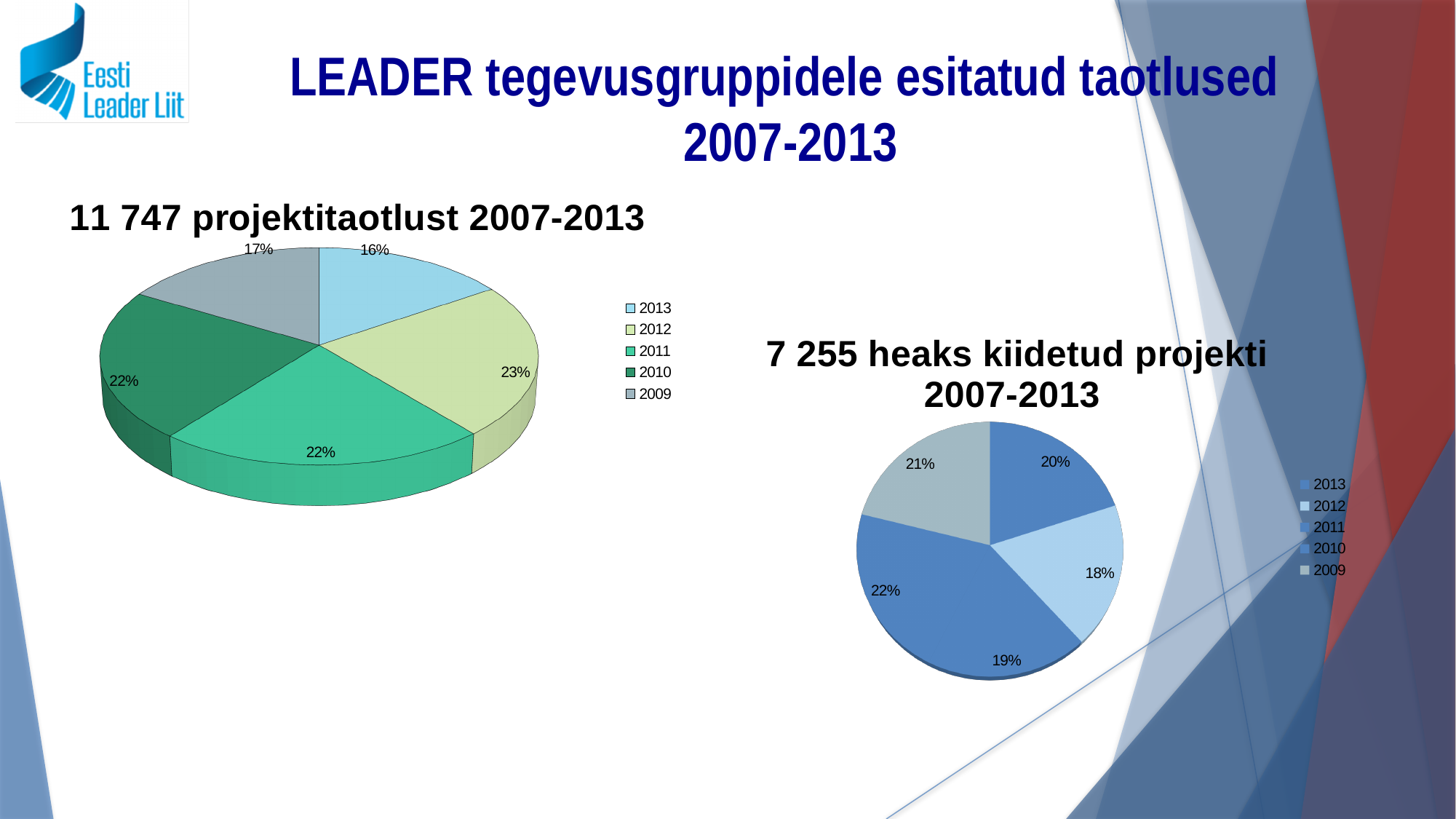
In the chart titled "11 747 projektitaotlust 2007-2013", which year has the largest slice? 2012 In the chart titled "11 747 projektitaotlust 2007-2013", what share of the pie does 2013 have? 16% In the chart titled "11 747 projektitaotlust 2007-2013", what share of the pie does 2012 have? 23% In the chart titled "7 255 heaks kiidetud projekti 2007-2013", how many years does the legend list? 5 In the chart titled "7 255 heaks kiidetud projekti 2007-2013", what share of the pie does 2013 have? 20% In the chart titled "11 747 projektitaotlust 2007-2013", which year has the smallest slice? 2013 In the chart titled "11 747 projektitaotlust 2007-2013", what is the difference in percentage points between the 2012 slice and the 2013 slice? 7 What kind of chart is the one titled "11 747 projektitaotlust 2007-2013"? Pie chart In the chart titled "7 255 heaks kiidetud projekti 2007-2013", which year has the smallest slice? 2012 In the chart titled "7 255 heaks kiidetud projekti 2007-2013", which year has the largest slice? 2010